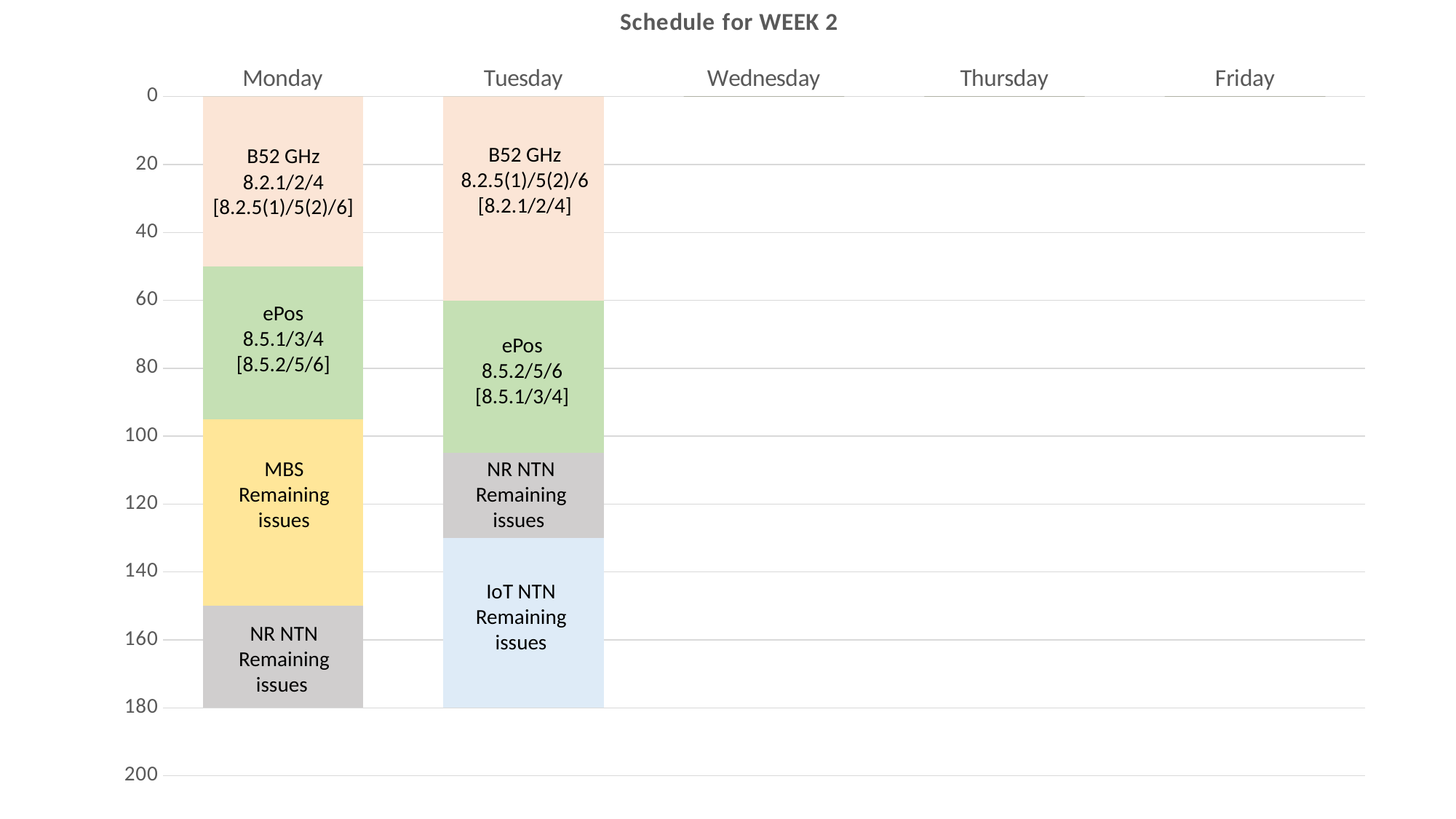
Which is larger: the B52 GHz segment on Monday or the B52 GHz segment on Tuesday? Tuesday Which segment is at the bottom of the Tuesday bar? IoT NTN Remaining issues Is the size of the NR NTN Remaining issues segment on Tuesday greater or less than 40? less How many segments make up the Monday bar? 4 At what axis value does the Tuesday bar end? 180 Which days have bars plotted in the chart? Monday and Tuesday What kind of chart is shown on the slide? Stacked bar chart What is the title of the chart? Schedule for WEEK 2 Which is larger on Monday: the MBS Remaining issues segment or the NR NTN Remaining issues segment? MBS Remaining issues How many segments make up the Tuesday bar? 4 At what axis value does the Monday bar end? 180 How many day categories are shown along the x axis? 5